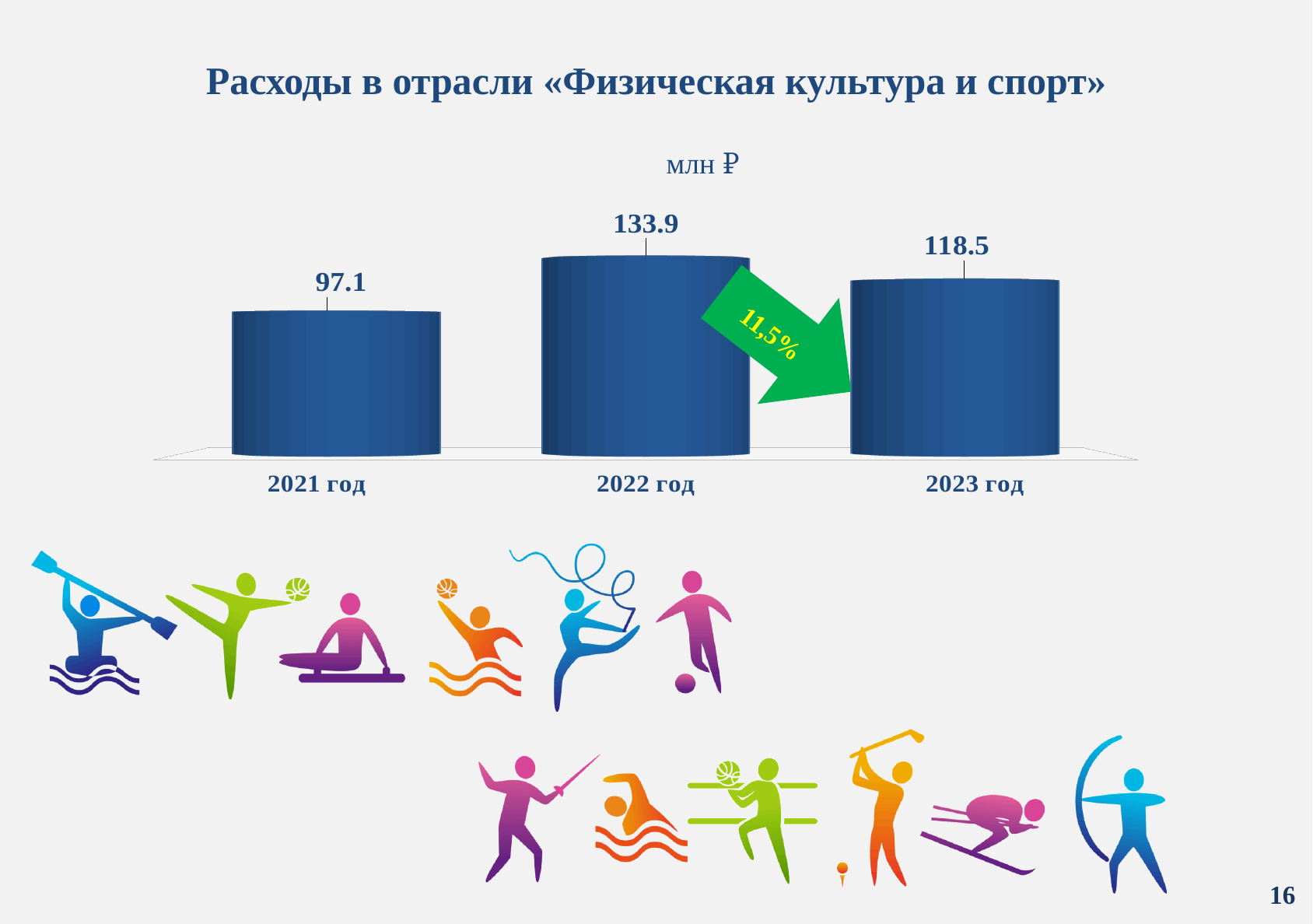
What percentage change is shown on the arrow between 2022 год and 2023 год? 11,5% Which year has the highest value? 2022 год What is the difference between the values for 2022 год and 2023 год? 15.4 What is the difference between the values for 2022 год and 2021 год? 36.8 What unit is indicated above the chart? млн ₽ Which is larger, the value for 2021 год or the value for 2023 год? 2023 год What is the value for 2022 год? 133.9 How many years are shown in the chart? 3 What kind of chart is shown on the slide? bar chart What is the value for 2023 год? 118.5 What is the value for 2021 год? 97.1 Which year has the lowest value? 2021 год